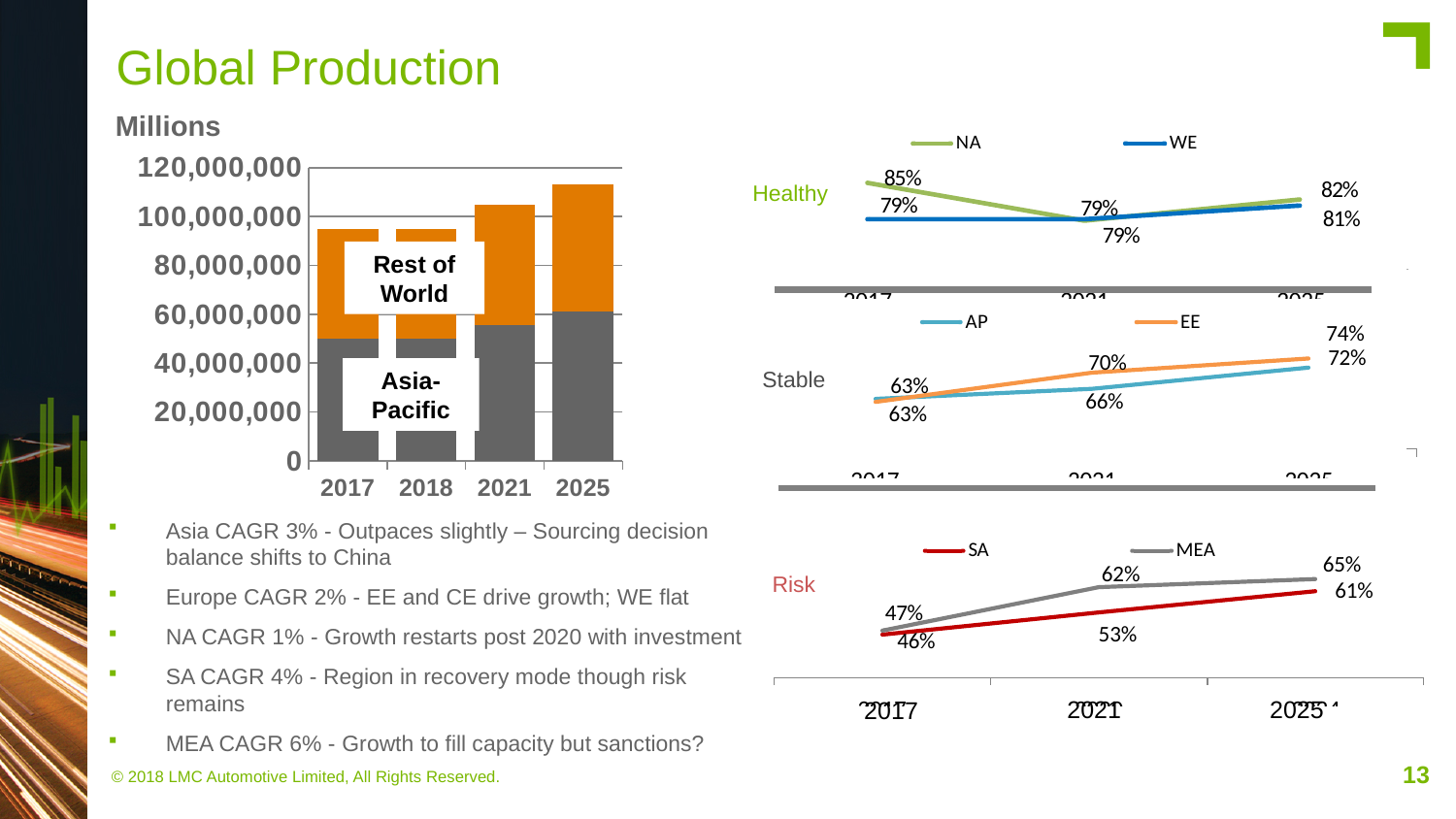
In the 'Risk' line chart, what is the difference between MEA and SA in 2025? 4 percentage points In the 'Risk' line chart, does the SA line rise or fall from 2017 to 2025? Rises In the 'Stable' line chart, what is the value for EE in 2021? 70% In the 'Healthy' line chart, what is the value for WE in 2025? 81% In the 'Millions' bar chart on the left, is the total for 2025 greater or less than 100,000,000? greater In the 'Stable' line chart, which series is higher in 2025, AP or EE? EE How many series does the 'Millions' bar chart on the left show? 2 In the 'Healthy' line chart, in which year is NA at its highest? 2017 What kind of chart is the 'Millions' chart on the left of the slide? Stacked bar chart How many years are shown on the x axis of the 'Millions' bar chart on the left? 4 In the 'Millions' bar chart on the left, is the total for 2017 greater or less than 100,000,000? less In the 'Healthy' line chart, what is the value for NA in 2017? 85%